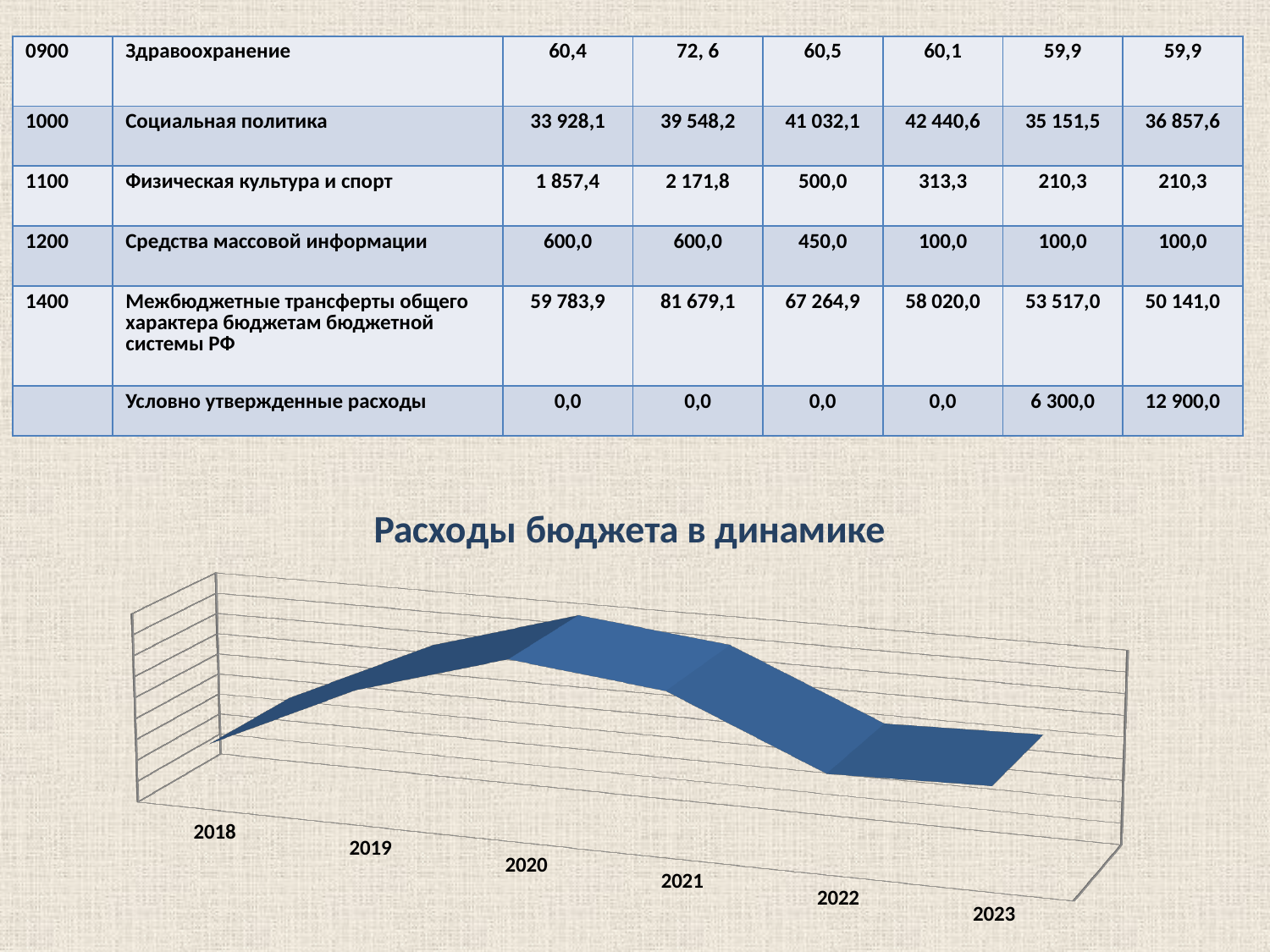
What kind of chart is shown under the title "Расходы бюджета в динамике"? 3D line chart Which year has the highest value in the chart? 2020 Which is larger in the chart, the value for 2019 or the value for 2022? 2019 Which is larger in the chart, the value for 2021 or the value for 2018? 2021 Is the value for 2020 larger or smaller than the value for 2023? larger Do the values in the chart rise or fall from 2018 to 2020? rise Do the values in the chart rise or fall from 2020 to 2022? fall How many years are shown on the x axis of the chart? 6 What is the first year shown on the x axis of the chart? 2018 What is the title of the chart on the slide? Расходы бюджета в динамике Which year has the lowest value in the chart? 2018